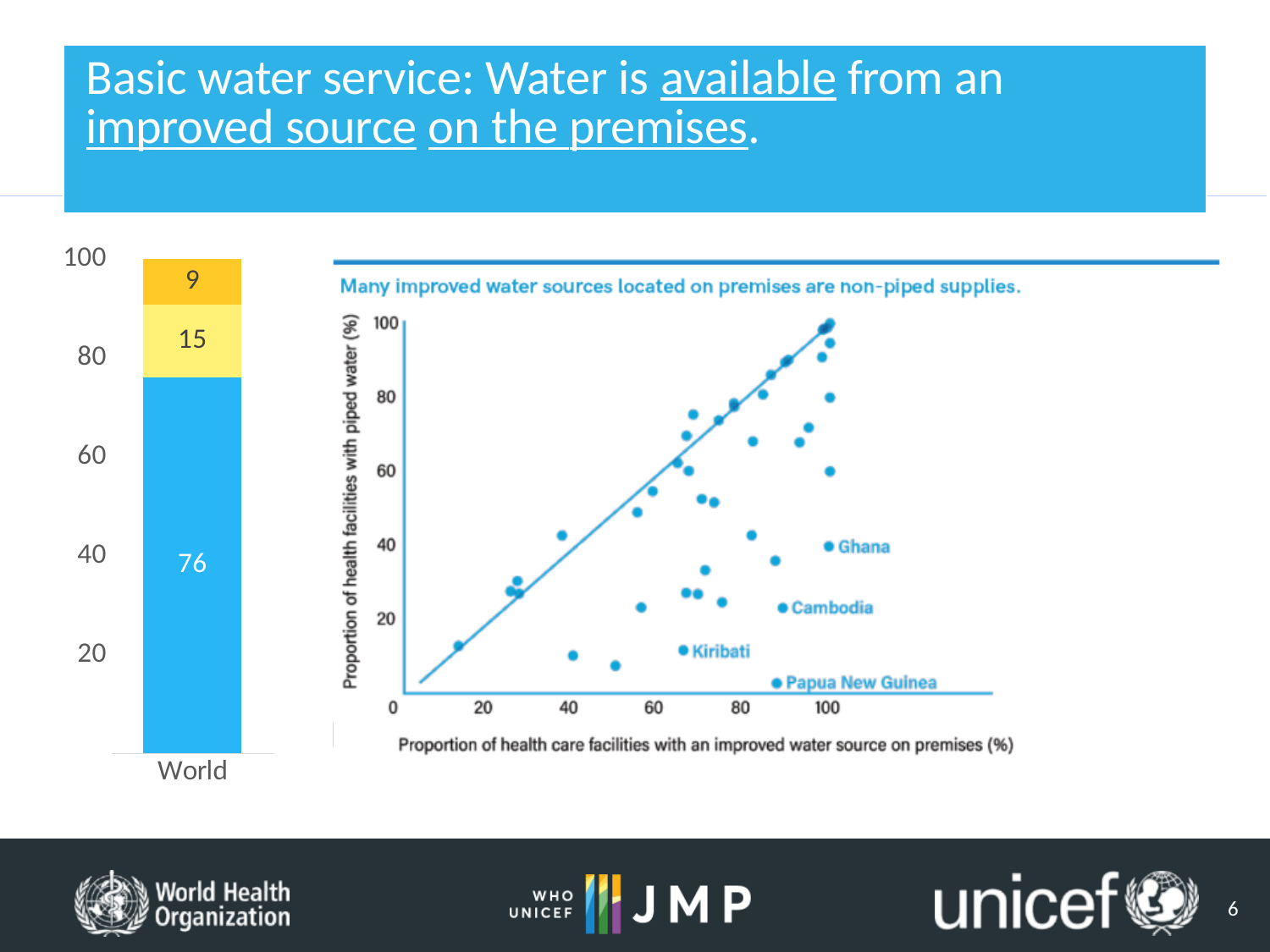
What kind of chart is shown on the right of the slide? Scatter plot In the scatter plot on the right, is the proportion of health facilities with piped water for Papua New Guinea greater or less than 20? less In the scatter plot on the right, which labelled country has a higher proportion of health facilities with piped water, Ghana or Kiribati? Ghana In the scatter plot on the right, is the proportion of health facilities with piped water for Ghana greater or less than 60? less In the stacked bar chart on the left, what is the value of the middle (yellow) segment for World? 15 In the stacked bar chart on the left, what is the value of the largest (blue) segment for World? 76 What kind of chart is shown on the left of the slide? Stacked bar chart In the stacked bar chart on the left, what is the value of the top (gold) segment for World? 9 In the stacked bar chart on the left, what is the difference between the blue segment (76) and the yellow segment (15)? 61 In the stacked bar chart on the left, how many categories are shown on the x axis? 1 In the stacked bar chart on the left, which segment is the smallest? The top (gold) segment, with a value of 9 In the stacked bar chart on the left, what is the total of the three segments for World? 100